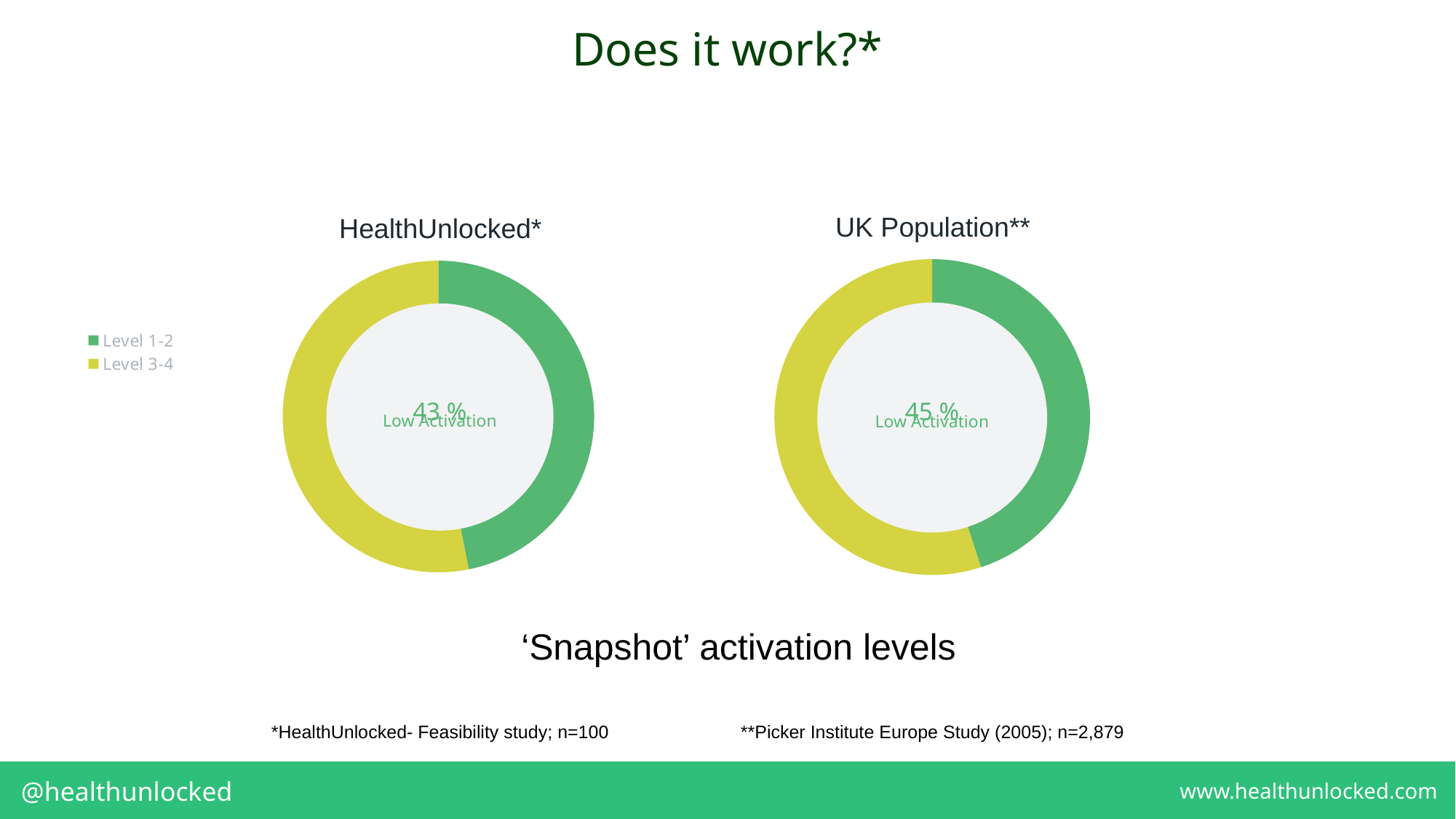
What percentage is shown in the centre of the UK Population** chart? 45 % Which colour represents Level 1-2 in the legend? Green How many slices does the UK Population** chart have? 2 In the HealthUnlocked* chart, which slice is larger, Level 1-2 or Level 3-4? Level 3-4 What kind of chart is the HealthUnlocked* chart? Doughnut (pie) chart In the UK Population** chart, which slice is larger, Level 1-2 or Level 3-4? Level 3-4 How many categories does the legend list for the charts? 2 What percentage is shown in the centre of the HealthUnlocked* chart? 43 % Which chart shows the higher Low Activation percentage, HealthUnlocked* or UK Population**? UK Population** What is the difference between the Low Activation percentages shown for UK Population** and HealthUnlocked*? 2 % What label appears in the centre of both charts below the percentage? Low Activation